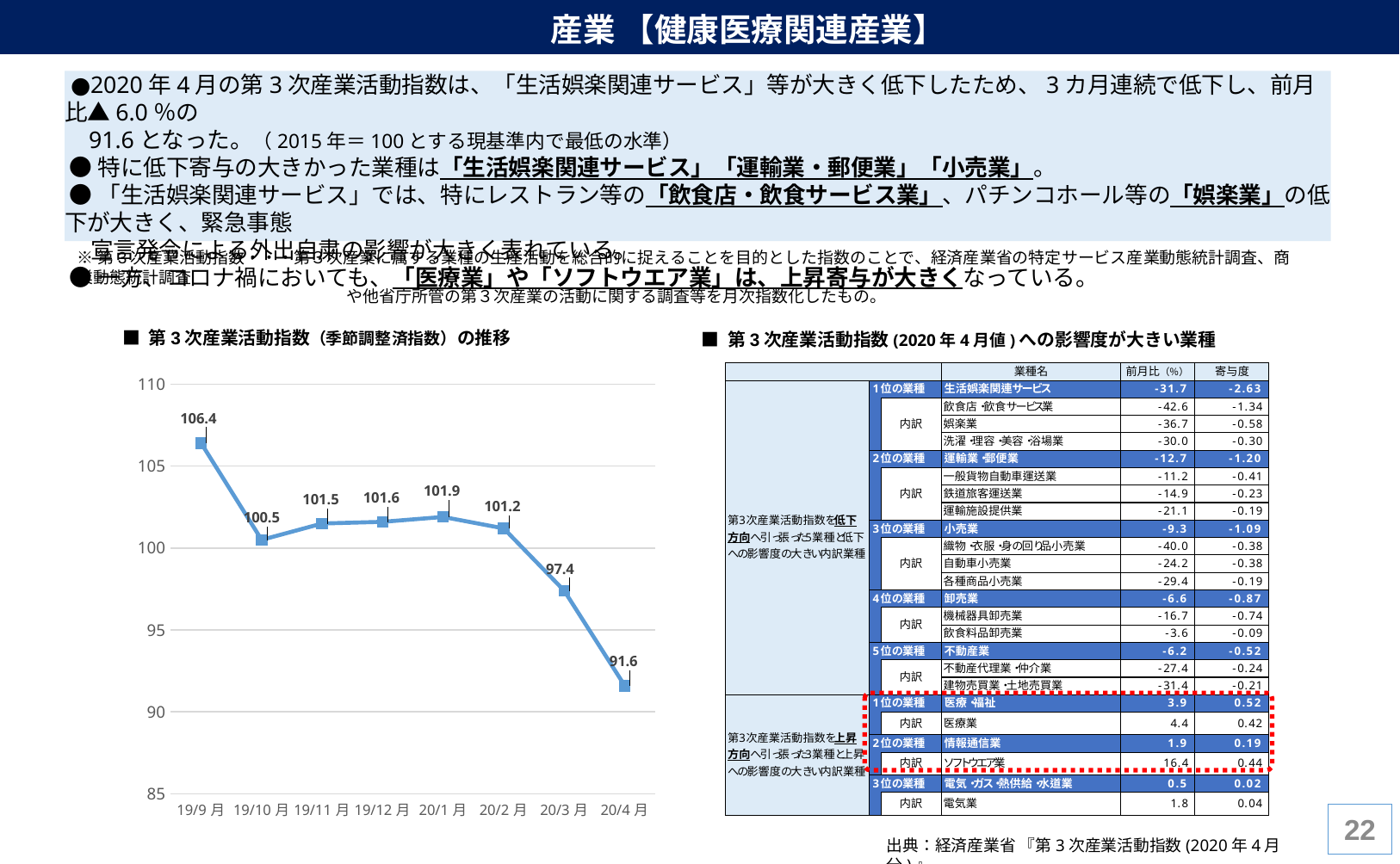
Is the value for 20/4月 in the line chart greater or less than 95? less What is the value for 20/3月 in the line chart? 97.4 What is the value for 20/4月 in the line chart? 91.6 What is the value for 19/9月 in the line chart? 106.4 Which is larger in the line chart, the value for 20/1月 or the value for 20/2月? 20/1月 Do the values in the line chart rise or fall from 20/1月 to 20/4月? fall What is the value for 19/10月 in the line chart? 100.5 Which month has the lowest value in the line chart? 20/4月 What is the difference between the values for 20/3月 and 20/4月 in the line chart? 5.8 Which month has the highest value in the line chart? 19/9月 What kind of chart is used to show the 第3次産業活動指数（季節調整済指数）の推移? line chart How many data points are plotted in the line chart? 8